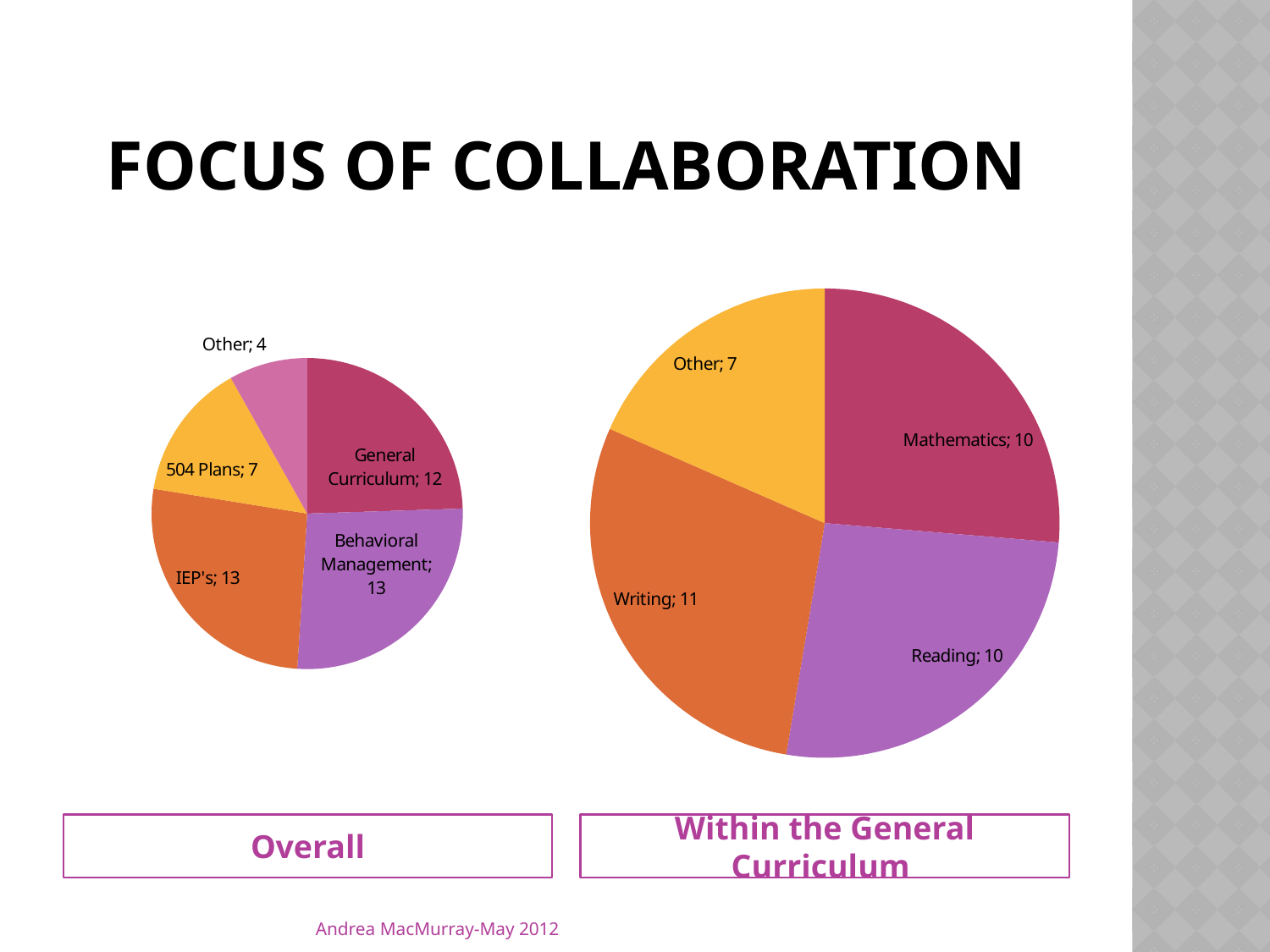
In the 'Within the General Curriculum' chart, what is the value for Writing? 11 In the 'Overall' chart, what is the difference between General Curriculum and Other? 8 In the 'Within the General Curriculum' chart, which category has the smallest value? Other In the 'Overall' chart, which category has the smallest value? Other In the 'Overall' chart, what is the value for 504 Plans? 7 In the 'Overall' chart, how many categories are shown? 5 In the 'Within the General Curriculum' chart, how many slices are there? 4 In the 'Overall' chart, which is larger: General Curriculum or 504 Plans? General Curriculum In the 'Overall' chart, what is the value for IEP's? 13 In the 'Within the General Curriculum' chart, which category has the largest value? Writing What type of chart is the 'Overall' chart on the left? Pie chart In the 'Within the General Curriculum' chart, what is the difference between Writing and Other? 4